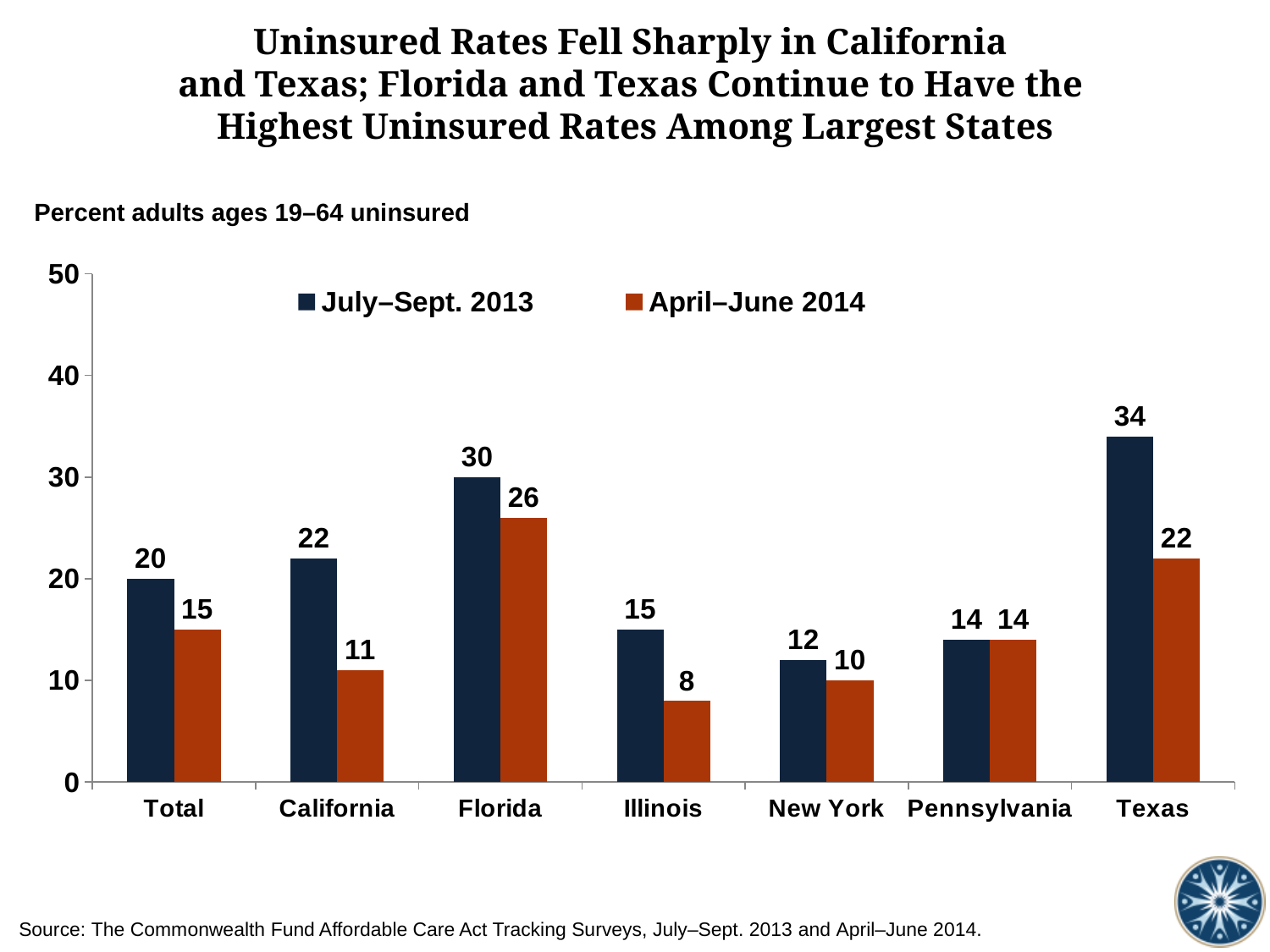
What is the difference between the July–Sept. 2013 and April–June 2014 values for Florida? 4 What kind of chart is shown on the slide? Bar chart What is the July–Sept. 2013 uninsured rate for Texas? 34 What is the April–June 2014 uninsured rate for California? 11 By how much did the uninsured rate in Texas fall from July–Sept. 2013 to April–June 2014? 12 How many categories are shown on the x axis? 7 How many series does the legend list? 2 Is the July–Sept. 2013 value for Florida greater or less than 20? greater Which is larger: the April–June 2014 value for Texas or the April–June 2014 value for Florida? Florida What is the April–June 2014 value for Illinois? 8 Which state has the highest April–June 2014 uninsured rate? Florida Which category has the lowest July–Sept. 2013 uninsured rate? New York